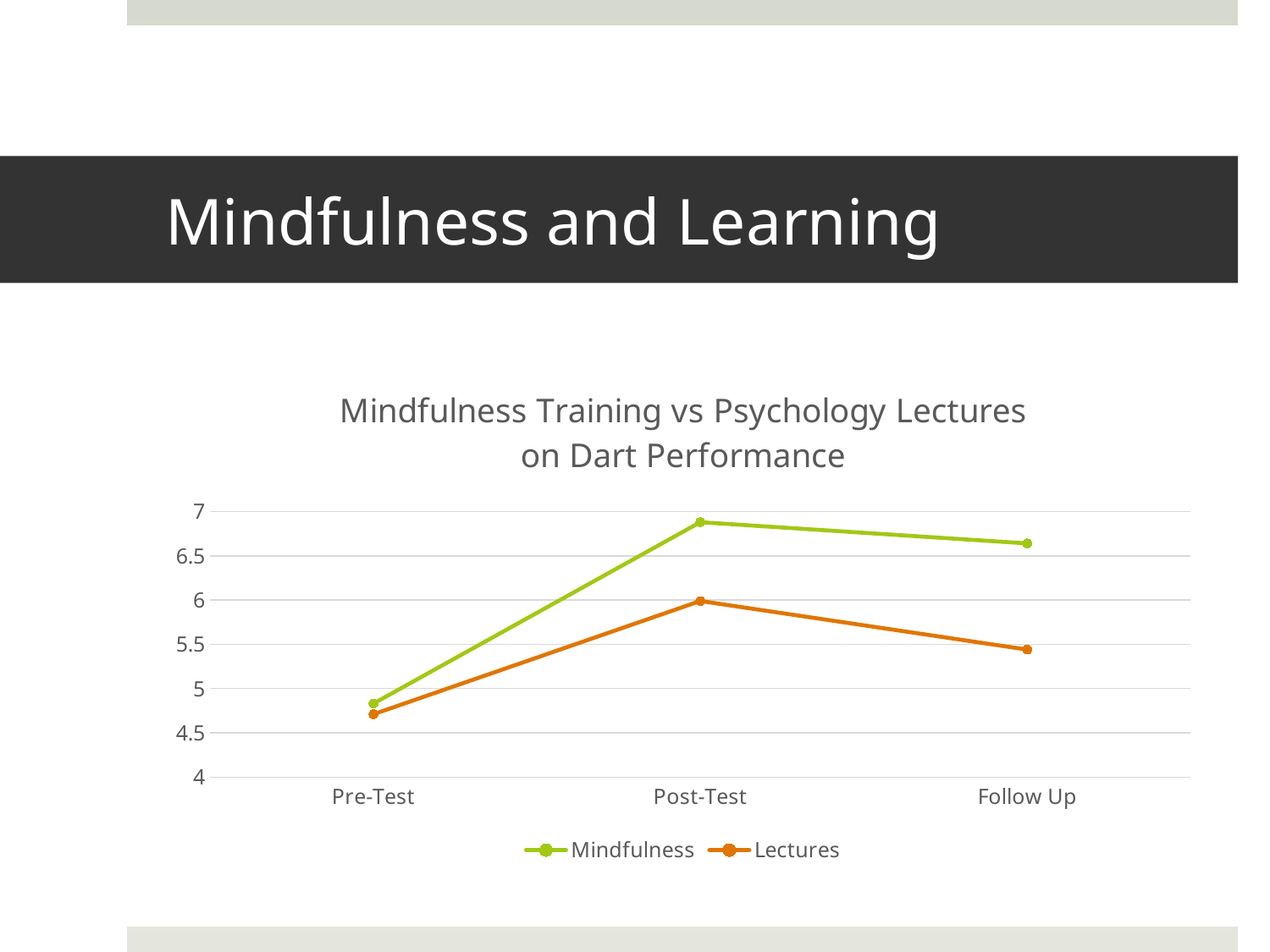
Is the Mindfulness value at Post-Test greater or less than 6.5? greater At Follow Up, which series has the larger value, Mindfulness or Lectures? Mindfulness How many time points are plotted along the x axis? 3 Is the Lectures value at Pre-Test greater or less than 5? less What is the title of the chart? Mindfulness Training vs Psychology Lectures on Dart Performance Does the Lectures series rise or fall from Post-Test to Follow Up? fall At Post-Test, which series has the larger value, Mindfulness or Lectures? Mindfulness At which time point is the Lectures series lowest? Pre-Test Is the Lectures value at Follow Up greater or less than 6? less What kind of chart is shown on the slide? line chart How many series does the legend list? 2 At which time point is the Mindfulness series highest? Post-Test